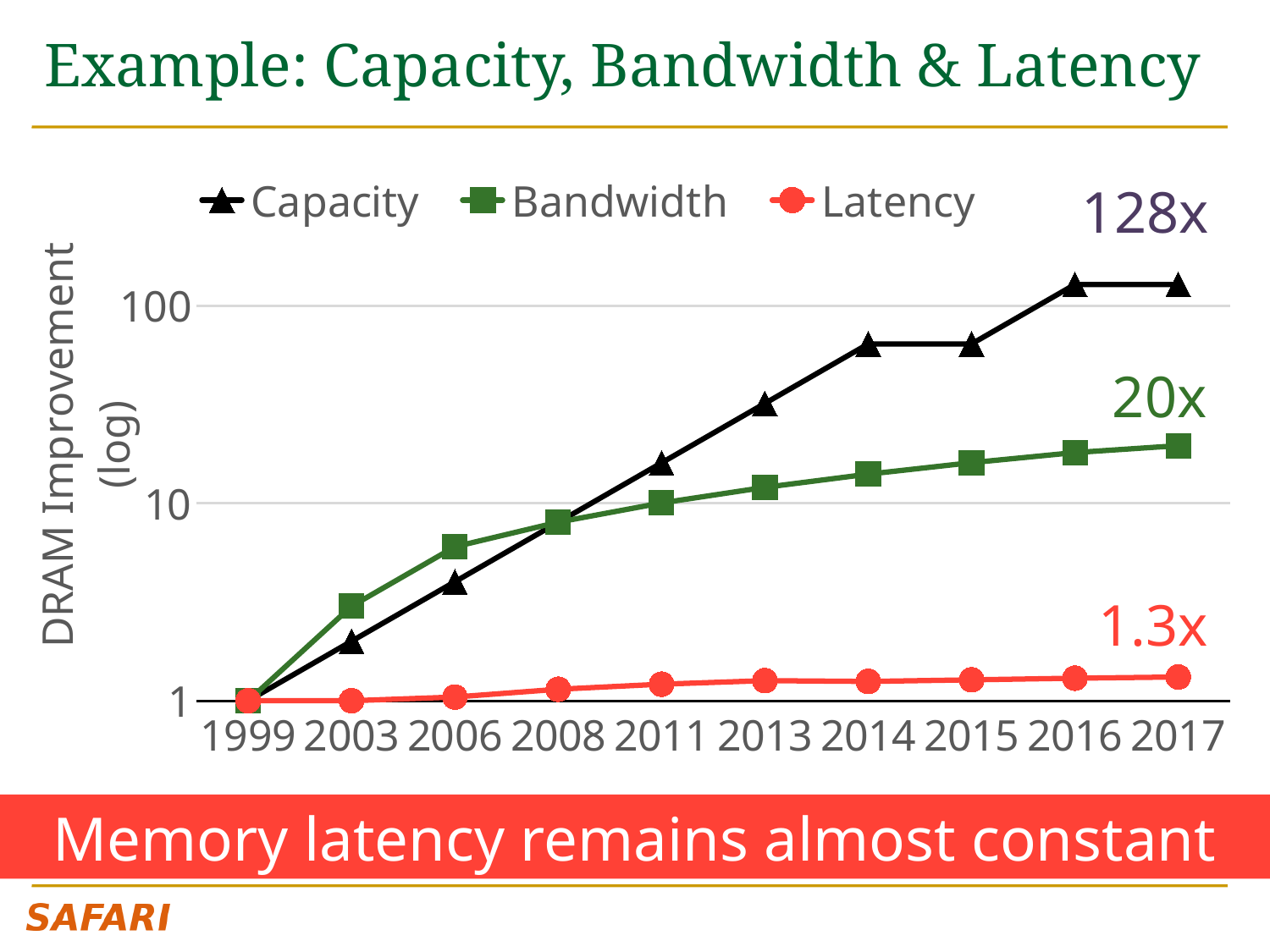
How many years are shown along the x axis? 10 What is the DRAM improvement for Capacity in 2017, as labelled on the chart? 128x Is the value for Capacity in 2013 greater or less than 10? greater Is the value for Bandwidth in 2008 greater or less than 10? less What is the DRAM improvement for Bandwidth in 2017, as labelled on the chart? 20x Does the Capacity series rise or fall from 1999 to 2017? rise What kind of chart is shown on the slide? line chart Which series has the lowest value in 2017? Latency How many series does the legend list? 3 What is the DRAM improvement for Latency in 2017, as labelled on the chart? 1.3x In 2006, which is larger: Capacity or Bandwidth? Bandwidth Which series has the highest value in 2017? Capacity